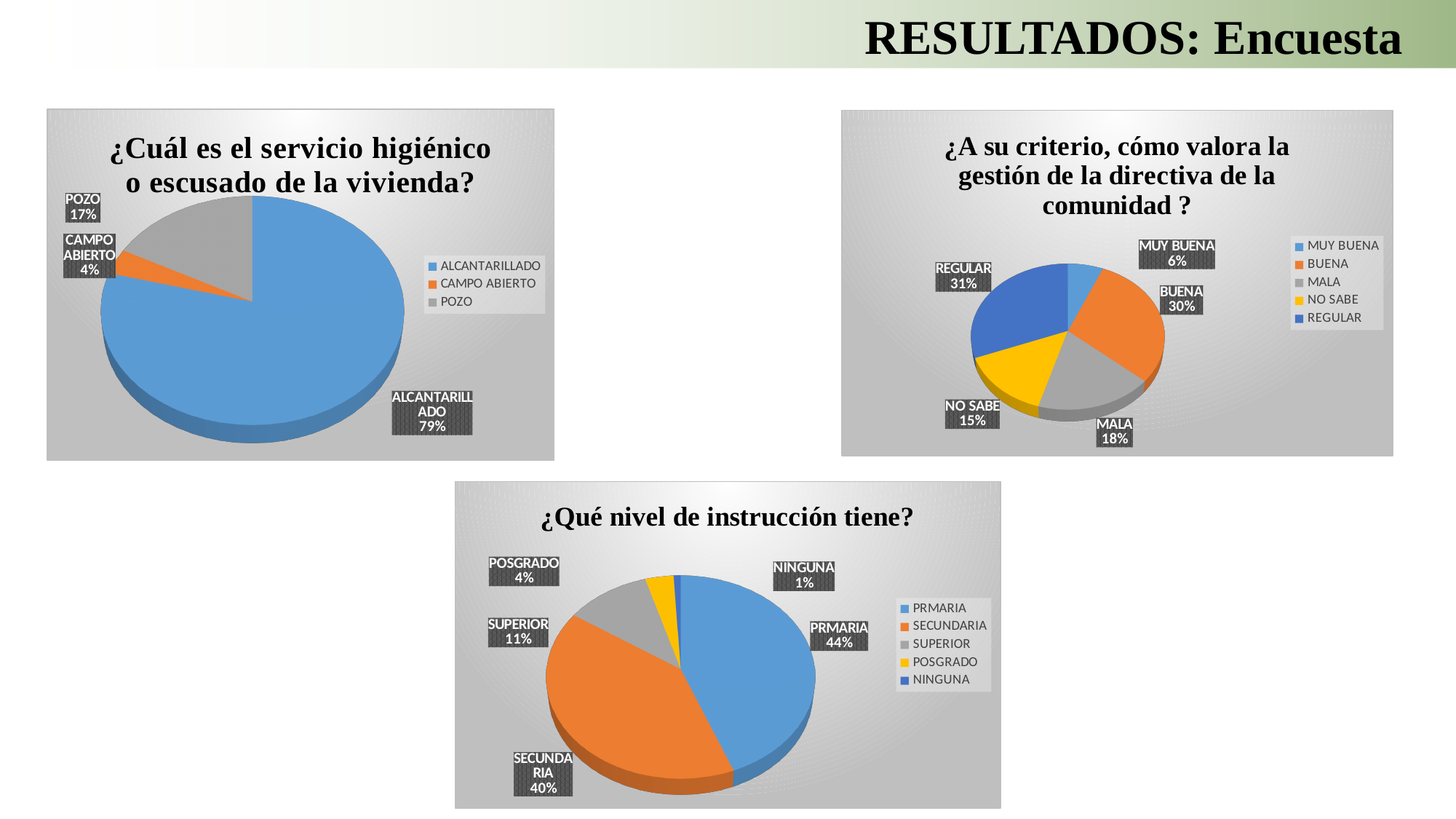
In the chart titled '¿A su criterio, cómo valora la gestión de la directiva de la comunidad ?', which category has the smallest share? MUY BUENA In the chart titled '¿A su criterio, cómo valora la gestión de la directiva de la comunidad ?', what share does NO SABE have? 15% In the chart titled '¿Cuál es el servicio higiénico o escusado de la vivienda?', how many categories are shown? 3 In the chart titled '¿Qué nivel de instrucción tiene?', what share does SECUNDARIA have? 40% In the chart titled '¿Cuál es el servicio higiénico o escusado de la vivienda?', what share does ALCANTARILLADO have? 79% What type of chart is the chart titled '¿Qué nivel de instrucción tiene?'? Pie chart In the chart titled '¿Qué nivel de instrucción tiene?', which is larger, SUPERIOR or POSGRADO? SUPERIOR In the chart titled '¿Cuál es el servicio higiénico o escusado de la vivienda?', which category has the smallest share? CAMPO ABIERTO In the chart titled '¿Qué nivel de instrucción tiene?', what is the difference between the PRMARIA and SECUNDARIA shares? 4% In the chart titled '¿A su criterio, cómo valora la gestión de la directiva de la comunidad ?', how many entries does the legend list? 5 In the chart titled '¿A su criterio, cómo valora la gestión de la directiva de la comunidad ?', which category has the largest share? REGULAR In the chart titled '¿Cuál es el servicio higiénico o escusado de la vivienda?', what is the difference between the POZO and CAMPO ABIERTO shares? 13%